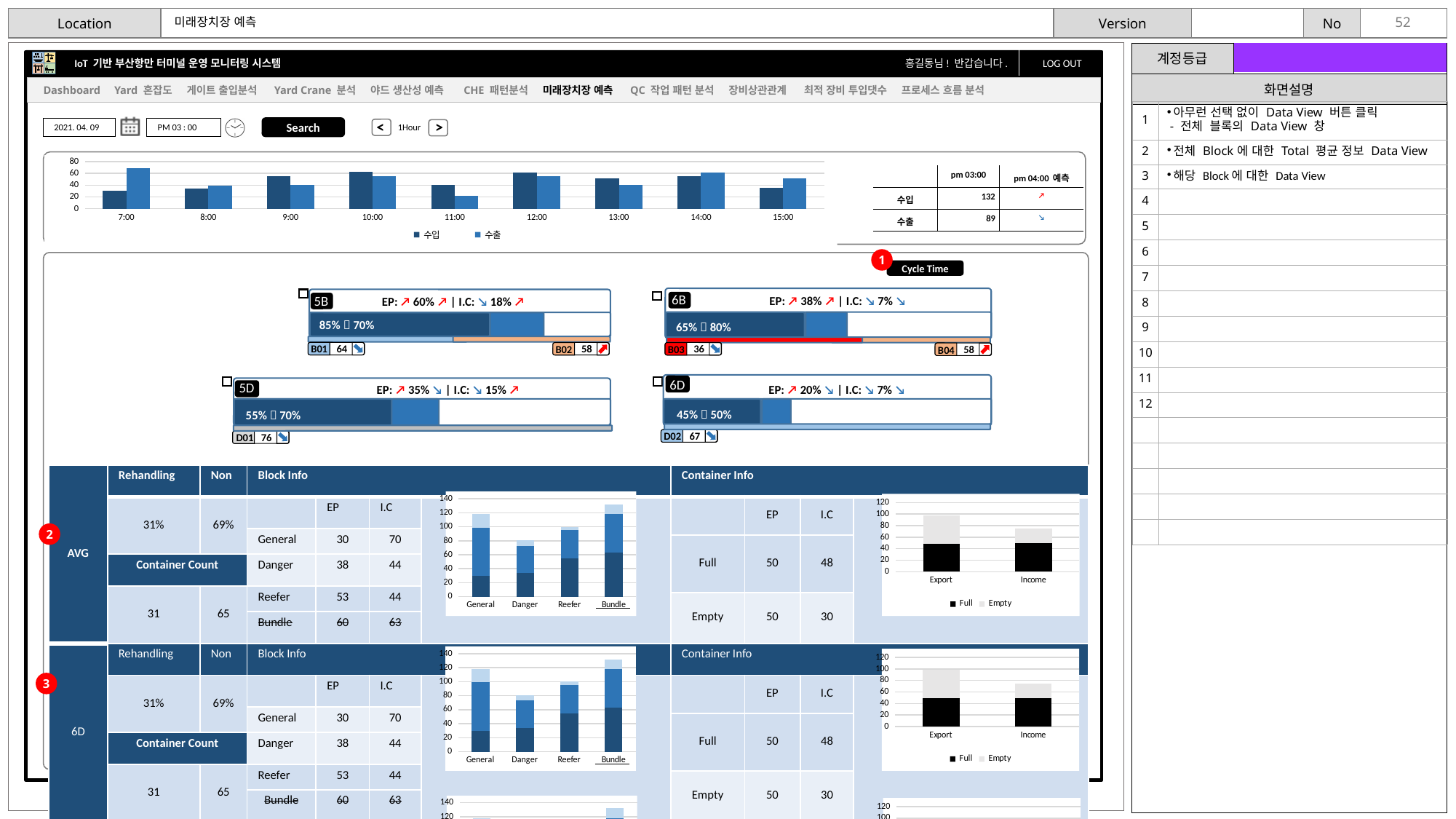
In the Block Info stacked bar chart of the AVG section, which category has the tallest bar? Bundle How many series does the legend of the top hourly bar chart list? 2 In the top hourly bar chart, is the 수출 value at 7:00 greater or less than 60? greater In the Block Info stacked bar chart of the AVG section, how many categories are on the x axis? 4 In the Container Info chart of the AVG section, which category has the taller stacked bar, Export or Income? Export In the Block Info stacked bar chart of the AVG section, is the total bar height for Danger greater or less than 100? less In the top hourly bar chart, at which time is the 수출 value highest? 7:00 What are the two legend entries of the top hourly bar chart? 수입, 수출 How many time categories are shown on the x axis of the top hourly bar chart? 9 In the top hourly bar chart, which is larger at 11:00, 수입 or 수출? 수입 In the top hourly bar chart, at which time is the 수출 value lowest? 11:00 What kind of chart is the hourly chart at the top of the slide (7:00 to 15:00)? bar chart